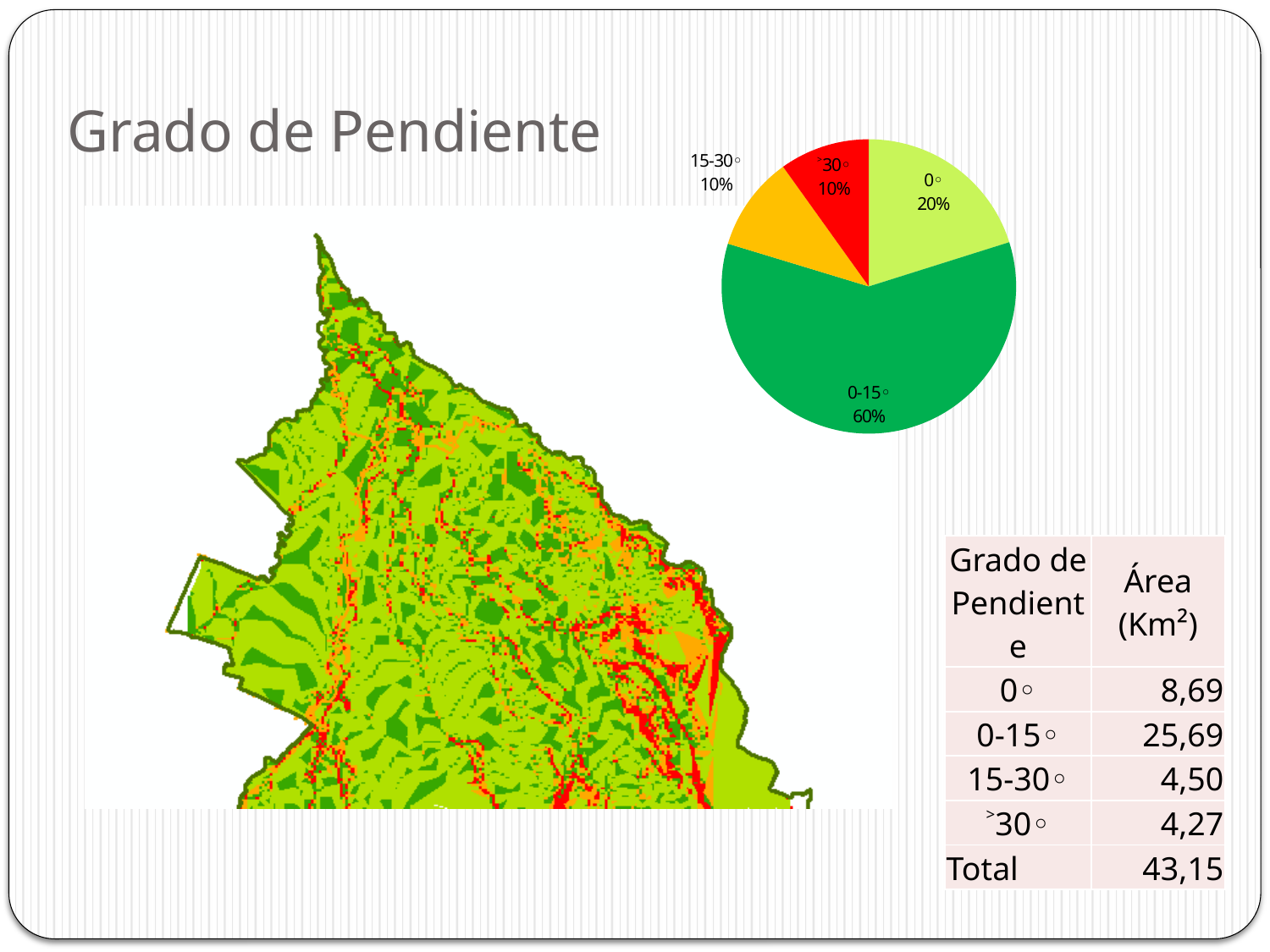
What percentage is shown for the 15-30° slice in the pie chart? 10% By how many percentage points does the 0-15° slice exceed the 0° slice in the pie chart? 40 percentage points Which is larger in the pie chart, the 0° slice or the 15-30° slice? 0° By how many percentage points does the 0° slice exceed the >30° slice in the pie chart? 10 percentage points What percentage is shown for the >30° slice in the pie chart? 10% What percentage is shown for the 0° slice in the pie chart? 20% What colour is the >30° slice in the pie chart? Red What kind of chart is shown on the slide? Pie chart Which slope category has the largest slice in the pie chart? 0-15° Which is larger in the pie chart, the 0° slice or the 0-15° slice? 0-15° What share of the pie chart does the 0-15° slice represent? 60% How many slices does the pie chart have? 4